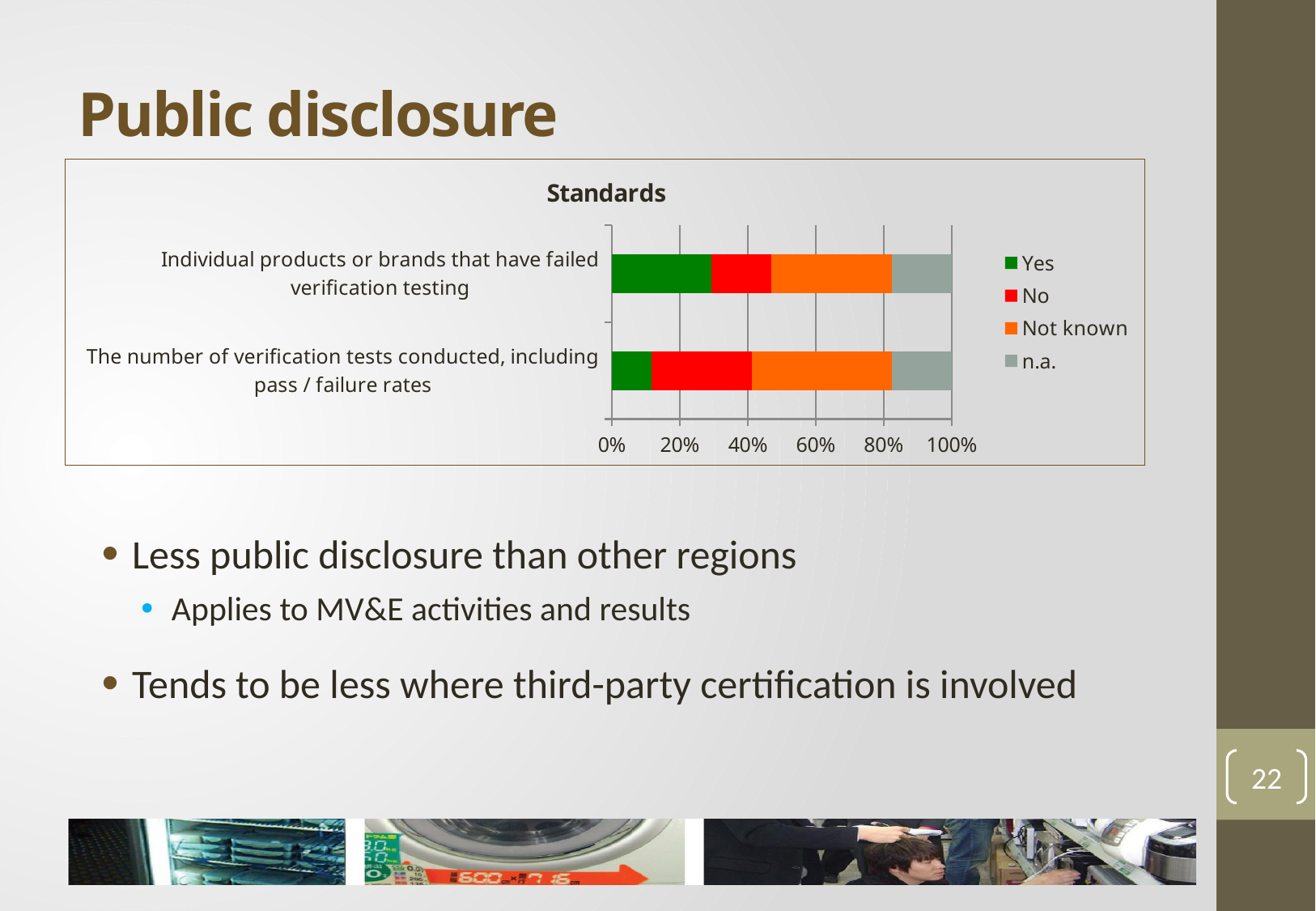
Which series takes the largest share of the bar for 'The number of verification tests conducted, including pass / failure rates'? Not known How many series does the chart legend list? 4 Which category has the smaller 'Yes' share? The number of verification tests conducted, including pass / failure rates Which category has the larger 'Yes' share: 'Individual products or brands that have failed verification testing' or 'The number of verification tests conducted, including pass / failure rates'? Individual products or brands that have failed verification testing Is the 'Yes' share for 'Individual products or brands that have failed verification testing' greater or less than 20%? greater What kind of chart is shown on the slide? stacked bar chart Which category has the larger 'No' share: 'Individual products or brands that have failed verification testing' or 'The number of verification tests conducted, including pass / failure rates'? The number of verification tests conducted, including pass / failure rates How many categories are plotted on the chart? 2 What is the title of the chart? Standards Which legend entry is shown in orange? Not known Is the 'Yes' share for 'The number of verification tests conducted, including pass / failure rates' greater or less than 20%? less What is the highest value shown on the horizontal axis of the chart? 100%